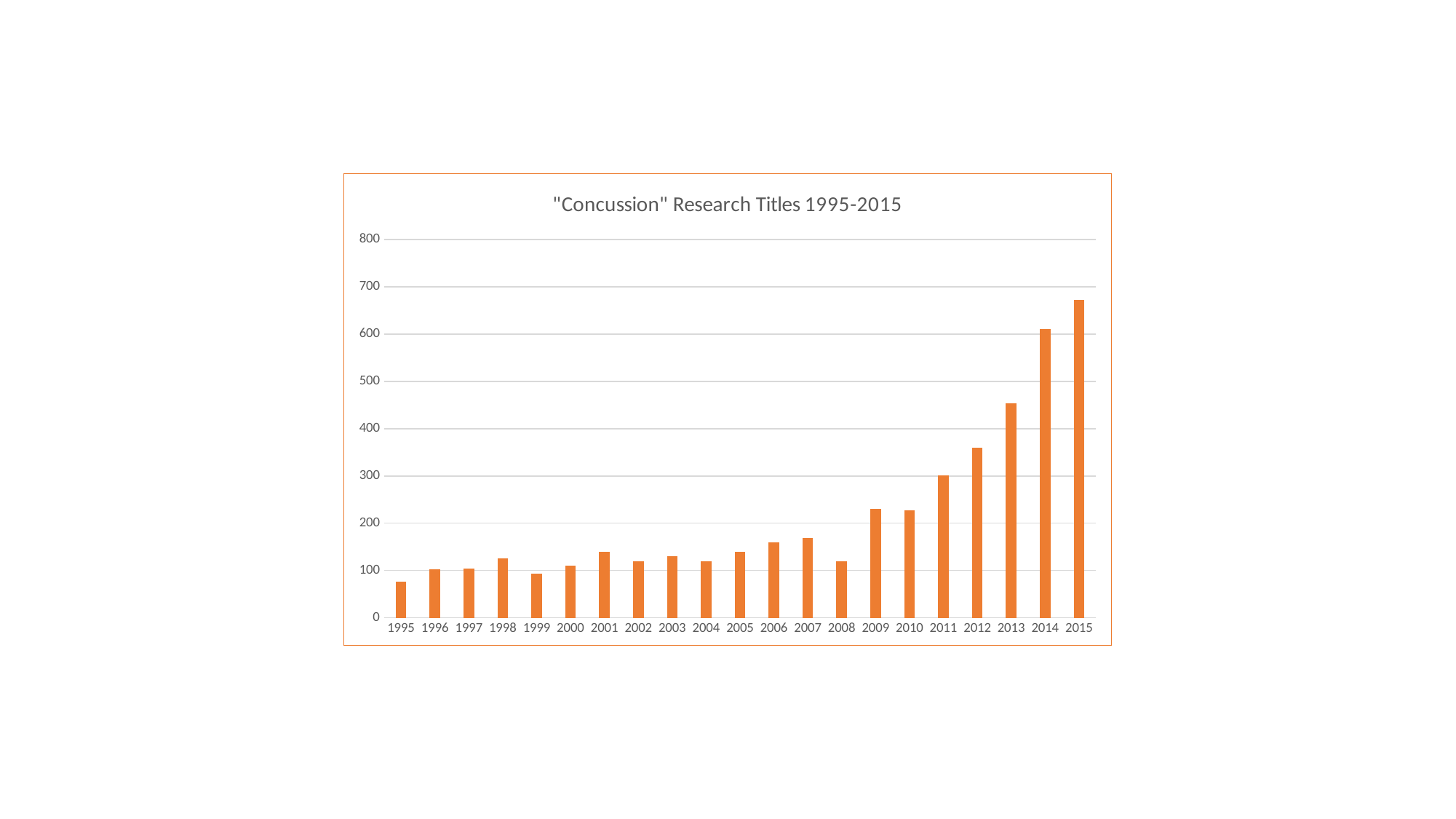
How many years (bars) are plotted in the chart? 21 Which year has the highest number of "Concussion" research titles? 2015 Is the value for 2015 greater or less than 600? greater Which year has a larger value, 2013 or 2012? 2013 What type of chart is shown on the slide? Bar chart Is the value for 2012 greater or less than 300? greater Which year has a larger value, 2008 or 2009? 2009 Overall, do the values rise or fall from 1995 to 2015? Rise Which year has the lowest number of "Concussion" research titles? 1995 Is the value for 2013 greater or less than 500? less What is the title of the chart? "Concussion" Research Titles 1995-2015